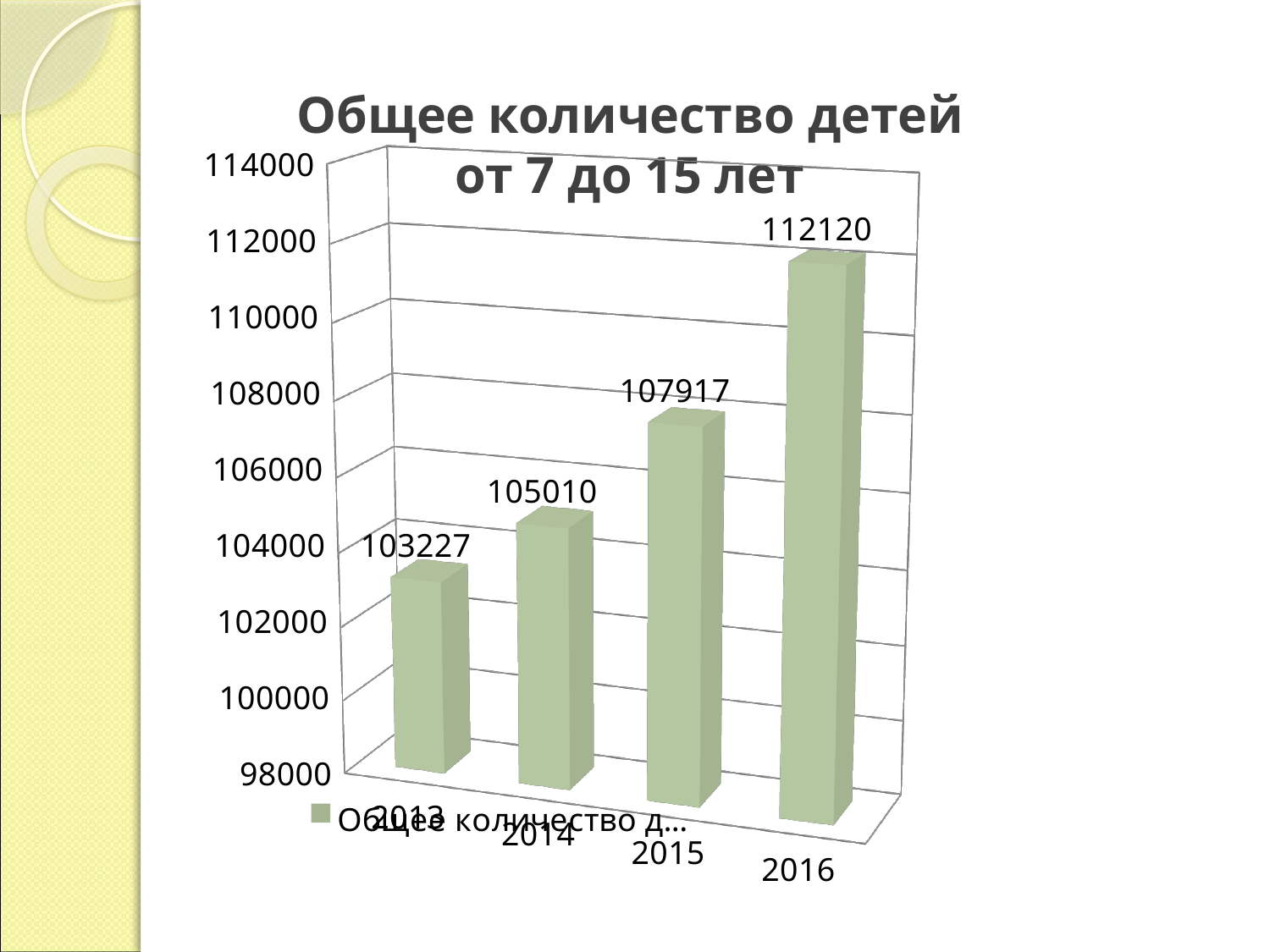
What is the difference between the values for 2015 and 2014? 2907 What is the value for 2015? 107917 Do the values rise or fall from 2013 to 2016? rise Which is larger, the value for 2014 or the value for 2015? 2015 Which year has the highest value? 2016 How many years are shown on the x axis? 4 What is the value for 2014? 105010 What is the value for 2013? 103227 What is the difference between the values for 2016 and 2013? 8893 Which year has the lowest value? 2013 What kind of chart is this? bar chart What is the value for 2016? 112120